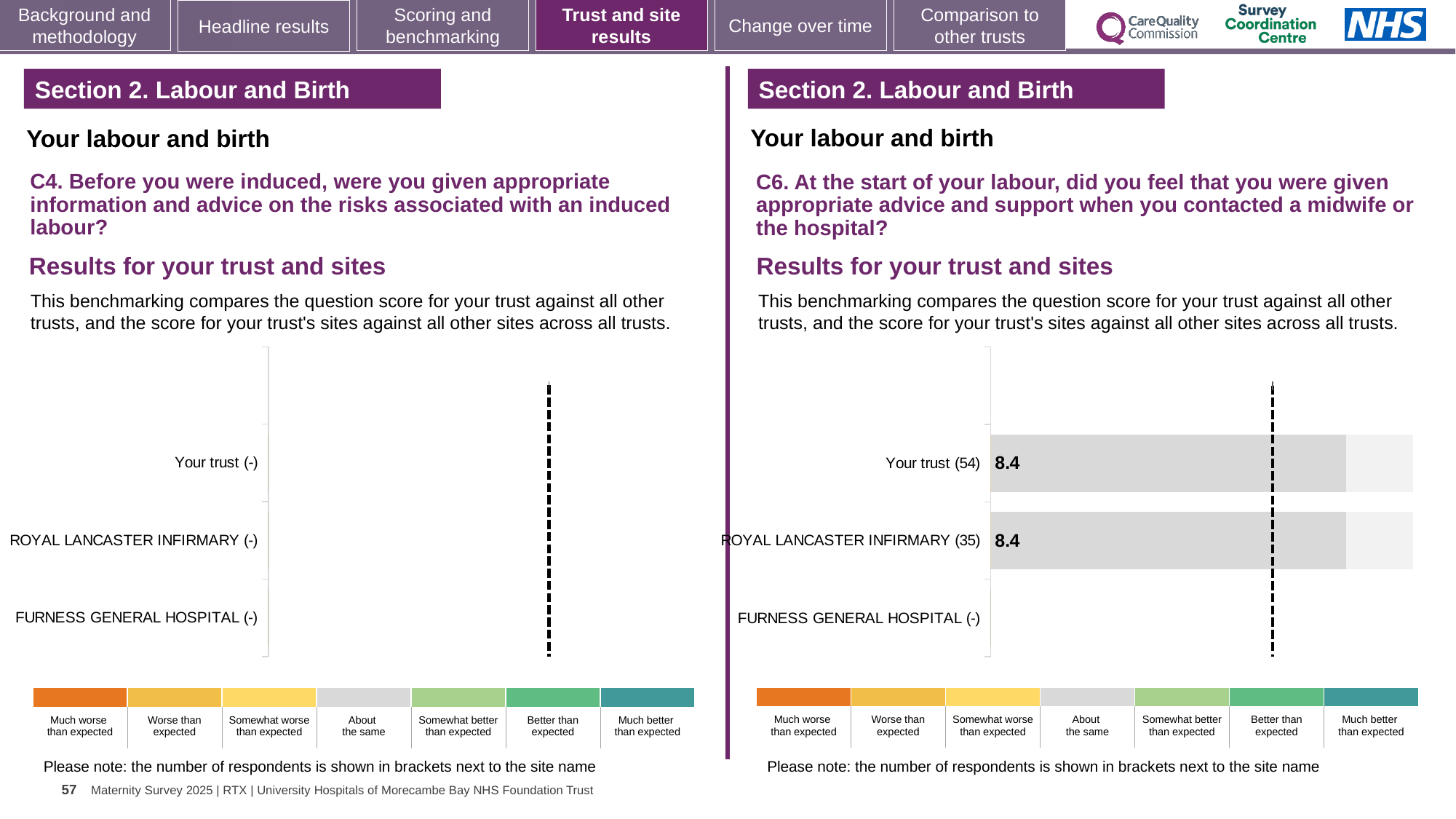
On the right chart (C6), how many respondents are shown in brackets for Your trust? 54 On the left chart (C4), what is shown in brackets next to Your trust? - What kind of chart is used on the right side of the slide (C6)? Bar chart On the right chart (C6), what is the score for ROYAL LANCASTER INFIRMARY? 8.4 On the right chart (C6), how many sites or trust rows are listed on the vertical axis? 3 How many benchmark categories are shown in the colour key below the right chart (C6)? 7 On the right chart (C6), how many respondents are shown in brackets for ROYAL LANCASTER INFIRMARY? 35 On the left chart (C4), how many sites or trust rows are listed on the vertical axis? 3 On the right chart (C6), what is the score for Your trust? 8.4 On the right chart (C6), what is the difference between the score for Your trust and the score for ROYAL LANCASTER INFIRMARY? 0 On the right chart (C6), which row has no score bar plotted? FURNESS GENERAL HOSPITAL